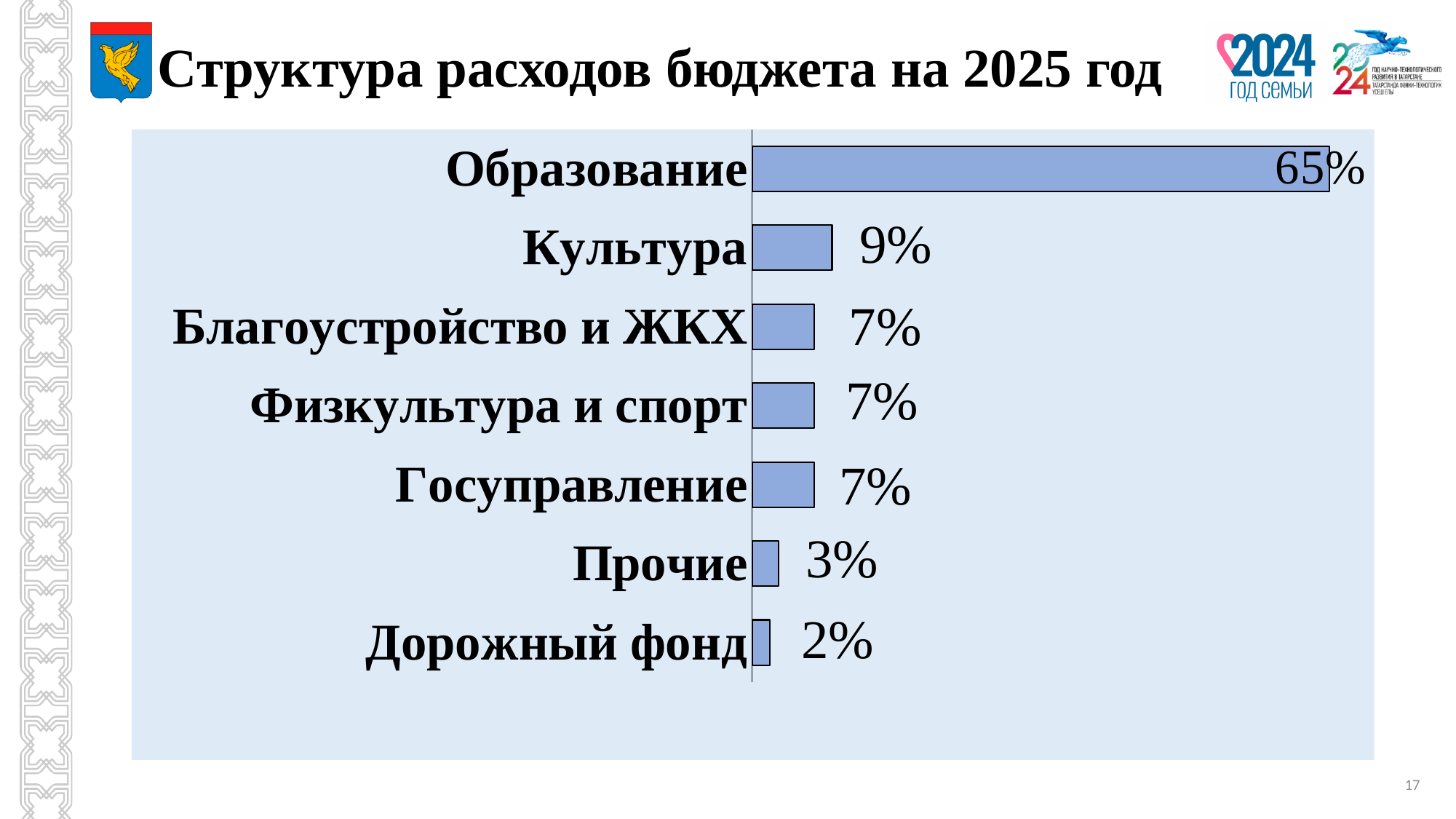
How many categories are shown in the chart? 7 Which is larger, the value for Культура or the value for Прочие? Культура What is the difference between the values for Образование and Культура? 56% What is the value for Дорожный фонд? 2% What is the value for Благоустройство и ЖКХ? 7% Which category has the highest value? Образование What is the value for Прочие? 3% Which category has the lowest value? Дорожный фонд What is the value for Культура? 9% What kind of chart is shown on the slide? Bar chart What is the title of the slide? Структура расходов бюджета на 2025 год What is the value for Образование? 65%